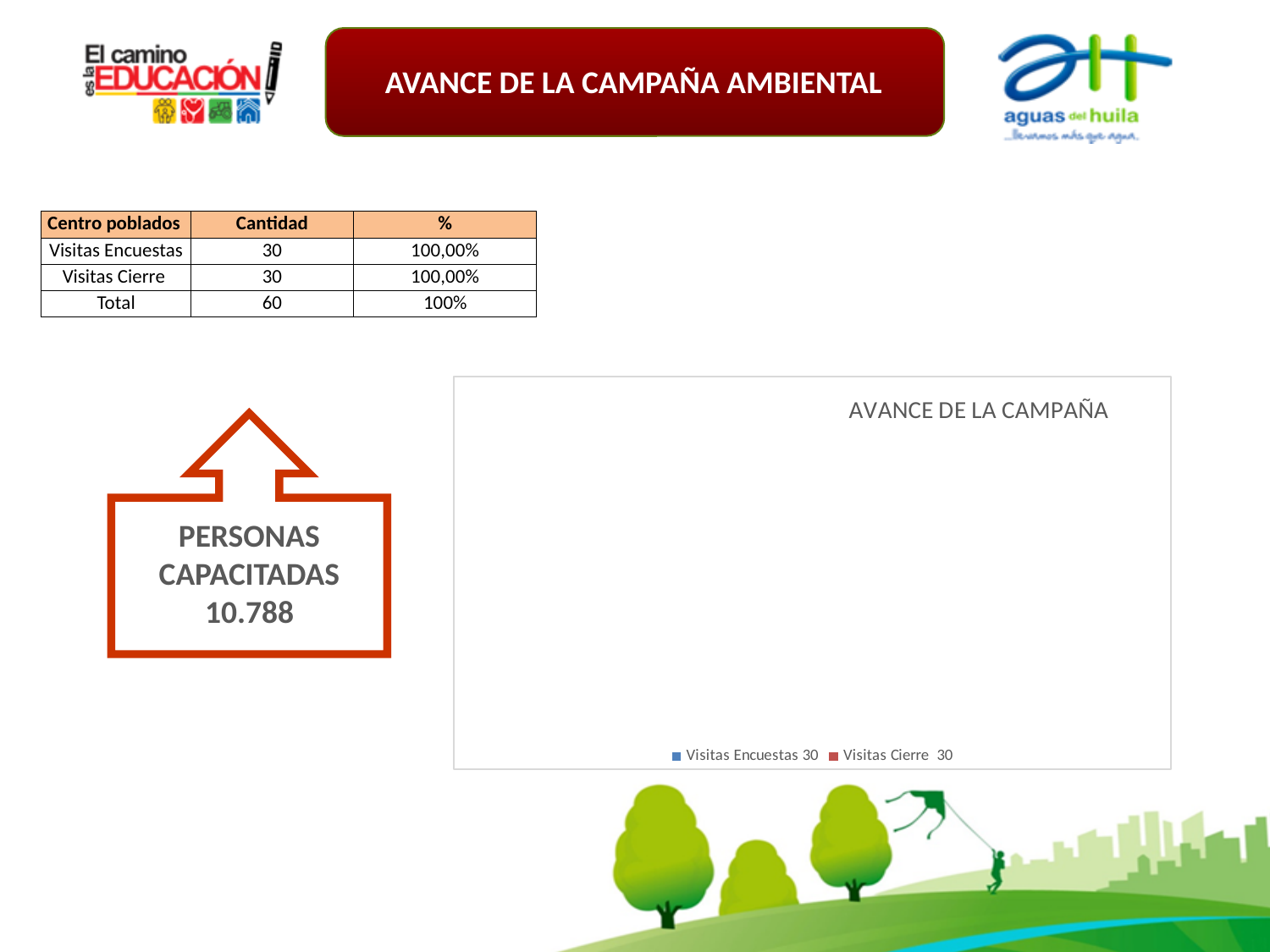
How many series does the chart's legend list? 2 What are the two entries listed in the chart's legend? Visitas Encuestas 30 and Visitas Cierre 30 According to the chart's legend, what value is shown for Visitas Cierre? 30 What is the title of the chart on the slide? AVANCE DE LA CAMPAÑA According to the chart's legend, what value is shown for Visitas Encuestas? 30